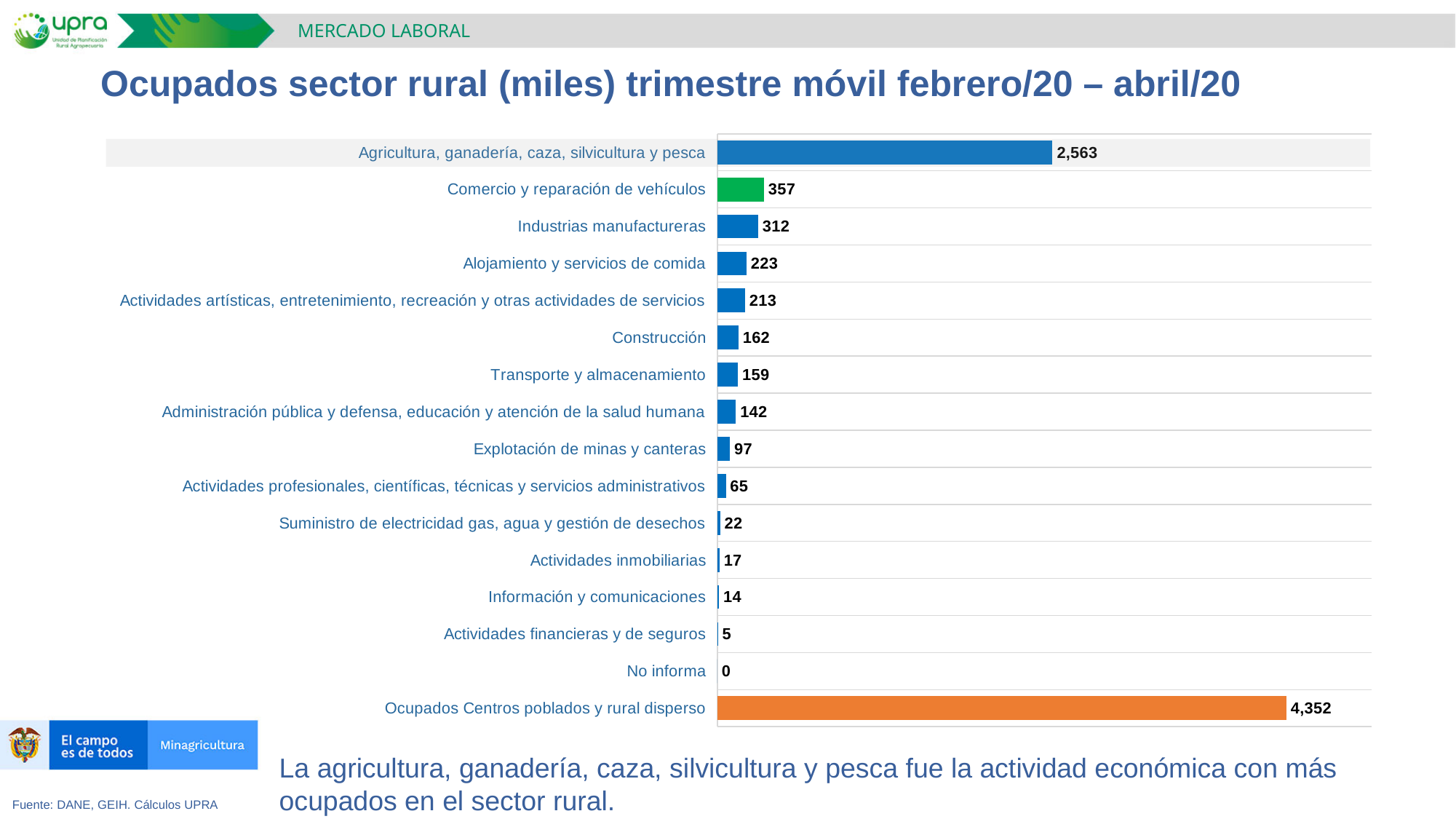
What kind of chart is shown on the slide? Bar chart What is the title of the chart? Ocupados sector rural (miles) trimestre móvil febrero/20 – abril/20 What is the value for Ocupados Centros poblados y rural disperso? 4,352 Which is larger, Transporte y almacenamiento or Explotación de minas y canteras? Transporte y almacenamiento What is the value for Comercio y reparación de vehículos? 357 Which category has the lowest value? No informa Which economic activity (excluding the total bar) has the highest number of occupied workers? Agricultura, ganadería, caza, silvicultura y pesca What is the value for Construcción? 162 What colour is the bar for Ocupados Centros poblados y rural disperso? Orange What is the difference between Industrias manufactureras and Alojamiento y servicios de comida? 89 What is the value for Agricultura, ganadería, caza, silvicultura y pesca? 2,563 How many categories are shown in the chart? 16